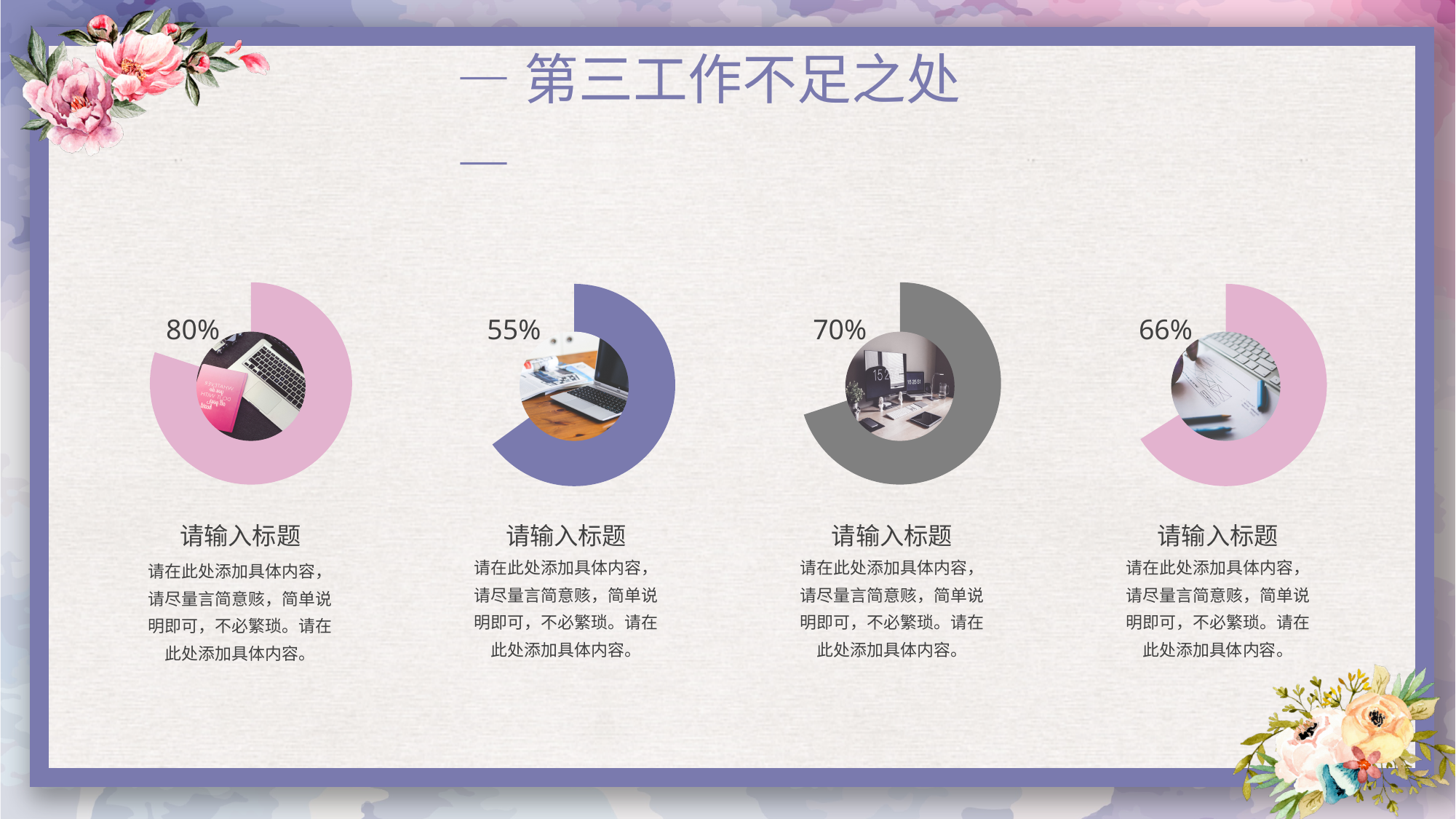
What percentage is shown on the leftmost donut chart? 80% Which is larger: the percentage on the third donut chart or the percentage on the rightmost donut chart? The third donut chart (70%) Which of the four donut charts shows the lowest percentage? The second chart from the left (55%) What percentage is shown on the third donut chart from the left? 70% What is the difference between the percentage on the third donut chart and the percentage on the rightmost donut chart? 4% What kind of chart is used to display the percentages on this slide? Donut chart What colour is the ring of the third donut chart from the left? Gray What is the difference between the percentage on the leftmost donut chart and the percentage on the second donut chart? 25% What percentage is shown on the rightmost donut chart? 66% Which of the four donut charts shows the highest percentage? The leftmost chart (80%) How many donut charts are shown on the slide? 4 What percentage is shown on the second donut chart from the left? 55%